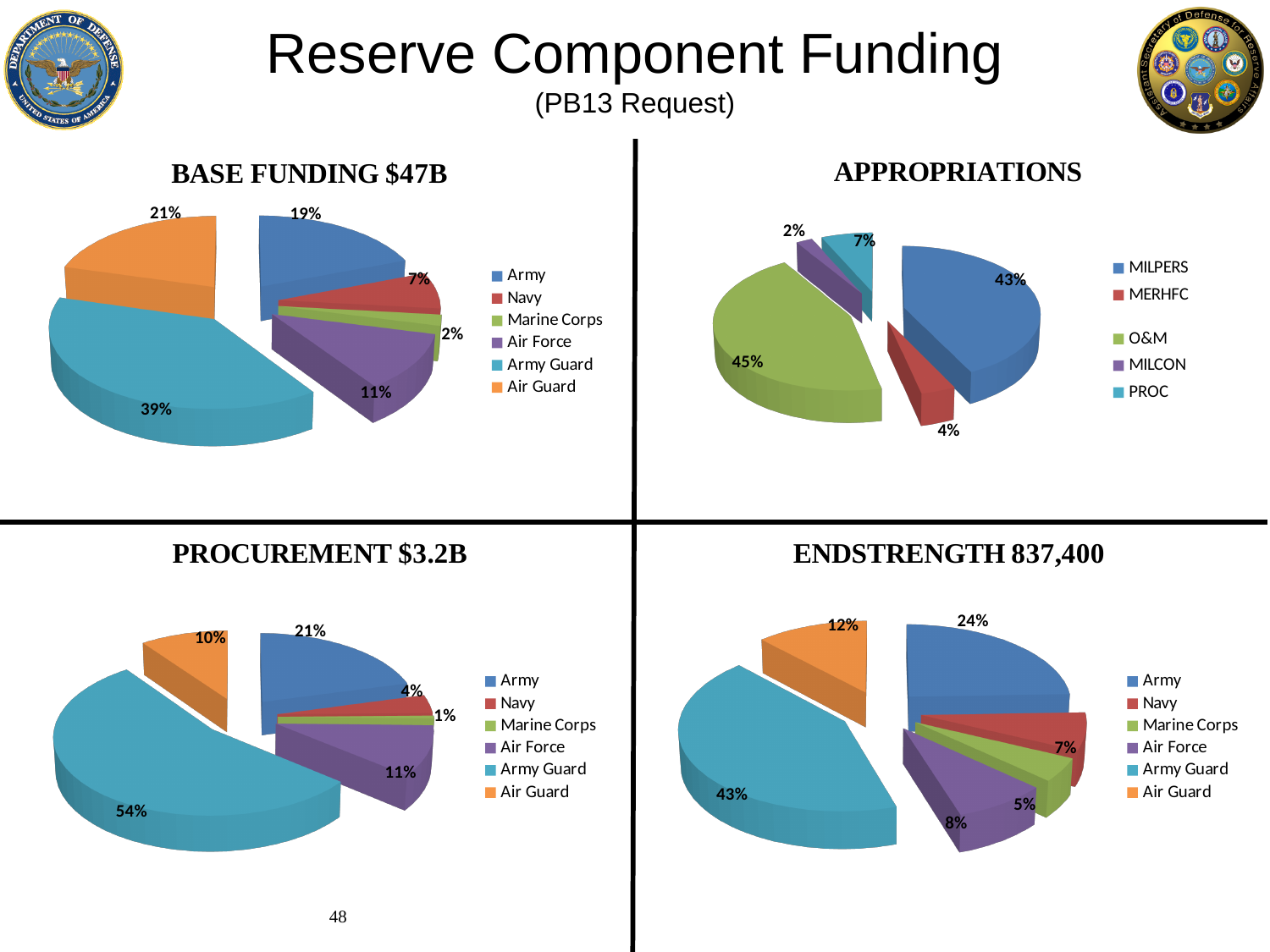
What type of chart is the ENDSTRENGTH 837,400 chart? Pie chart In the ENDSTRENGTH 837,400 chart, which category has the largest share? Army Guard How many categories does the legend of the APPROPRIATIONS chart list? 5 In the BASE FUNDING $47B chart, what is the difference between the Air Guard share and the Army share? 2% In the BASE FUNDING $47B chart, what share does Army Guard have? 39% In the ENDSTRENGTH 837,400 chart, what share does Air Force have? 8% In the PROCUREMENT $3.2B chart, what share does Army Guard have? 54% In the APPROPRIATIONS chart, which category has the smallest share? MILCON In the BASE FUNDING $47B chart, which category has the smallest share? Marine Corps In the PROCUREMENT $3.2B chart, what colour is the Army Guard slice? Teal In the PROCUREMENT $3.2B chart, which is larger, the Air Force share or the Air Guard share? Air Force In the APPROPRIATIONS chart, what share does O&M have? 45%